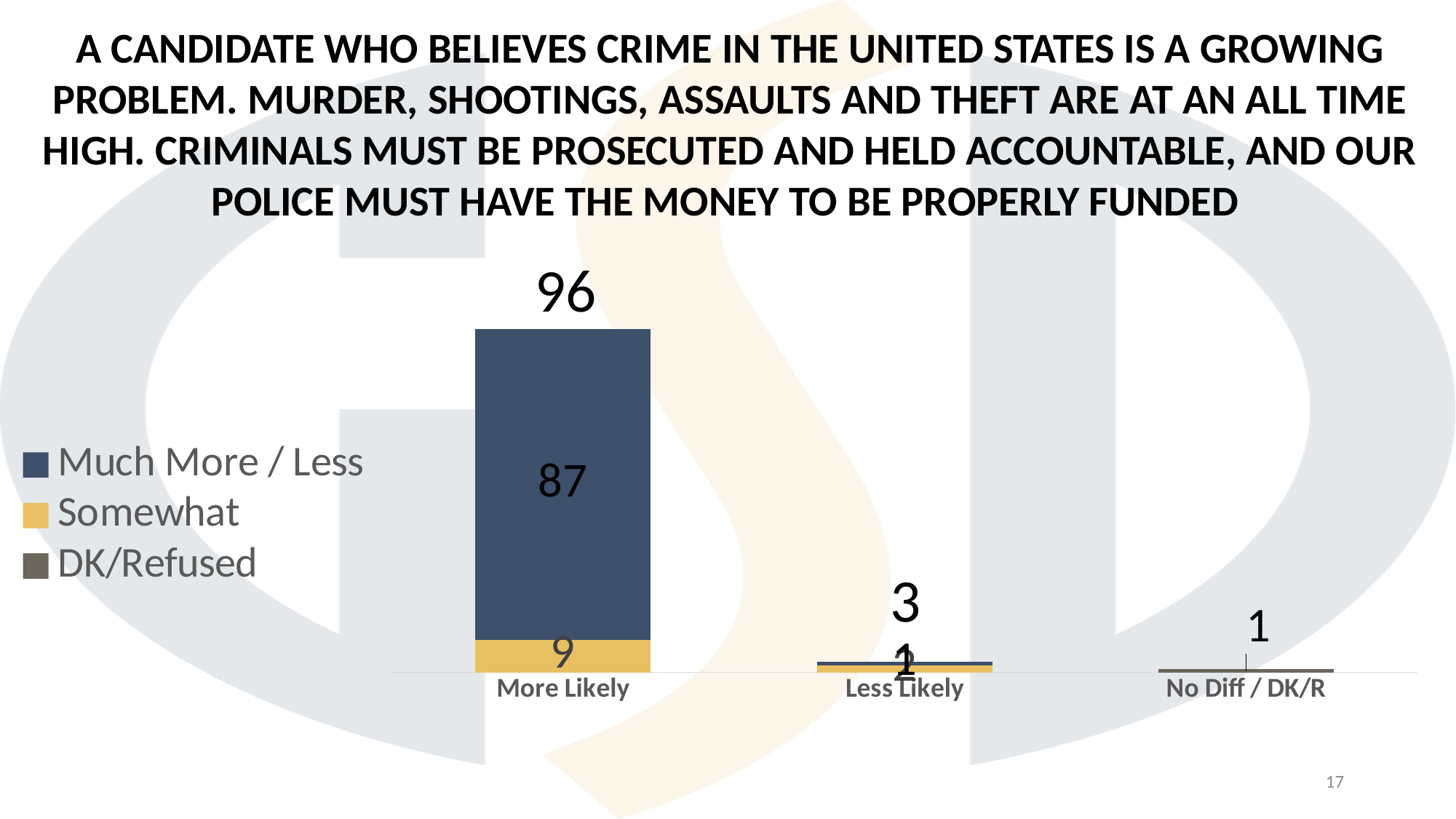
What is the total value shown above the More Likely bar? 96 How many categories are shown on the x axis? 3 What is the difference between the More Likely total and the Less Likely total? 93 How many series does the legend list? 3 Which category has the highest total? More Likely What is the value shown for No Diff / DK/R? 1 What is the value of the Somewhat segment in the More Likely bar? 9 What is the total value shown above the Less Likely bar? 3 What kind of chart is shown on the slide? Stacked bar chart What is the value of the Much More / Less segment in the More Likely bar? 87 Which category has the lowest total? No Diff / DK/R What is the difference between the Much More / Less segment and the Somewhat segment in the More Likely bar? 78